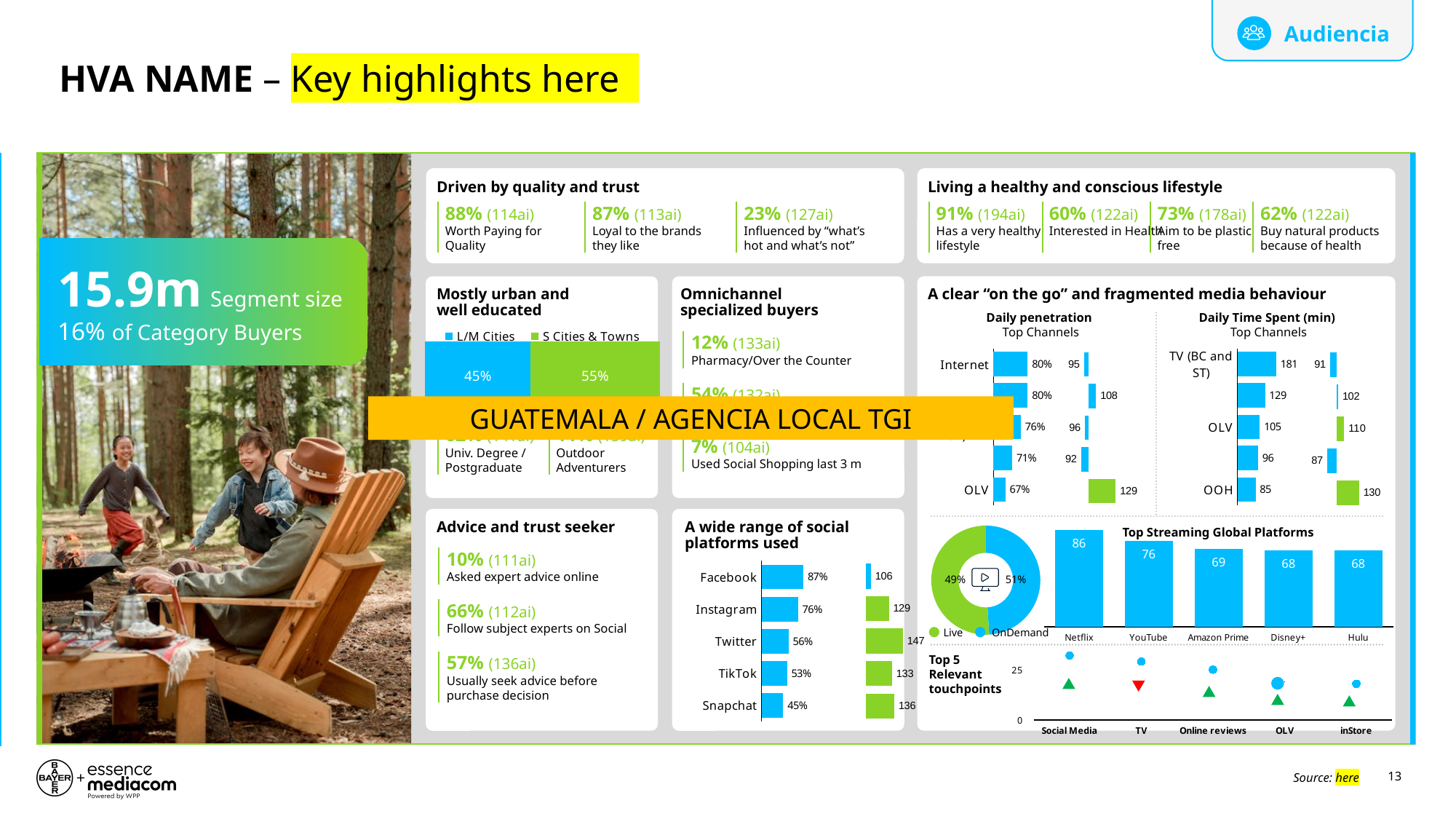
In the 'Top Streaming Global Platforms' chart, which platform has the highest value? Netflix In the 'A wide range of social platforms used' chart, which platform has the lowest percentage? Snapchat In the 'Mostly urban and well educated' stacked bar, what percentage is shown for S Cities & Towns? 55% In the 'Daily Time Spent (min) Top Channels' chart, what is the value for OOH? 85 In the 'Top Streaming Global Platforms' chart, what is the difference between the values for Netflix and YouTube? 10 In the 'Top Streaming Global Platforms' chart, what is the value for Netflix? 86 In the 'A wide range of social platforms used' chart, what percentage is shown for Instagram? 76% How many platforms are shown in the 'Top Streaming Global Platforms' chart? 5 In the 'Daily Time Spent (min) Top Channels' chart, what is the value for TV (BC and ST)? 181 In the donut chart with the Live and OnDemand legend, what share is shown for OnDemand? 51% In the 'A wide range of social platforms used' chart, which is larger, the percentage for Twitter or for TikTok? Twitter In the 'Daily penetration Top Channels' chart, what percentage is shown for OLV? 67%